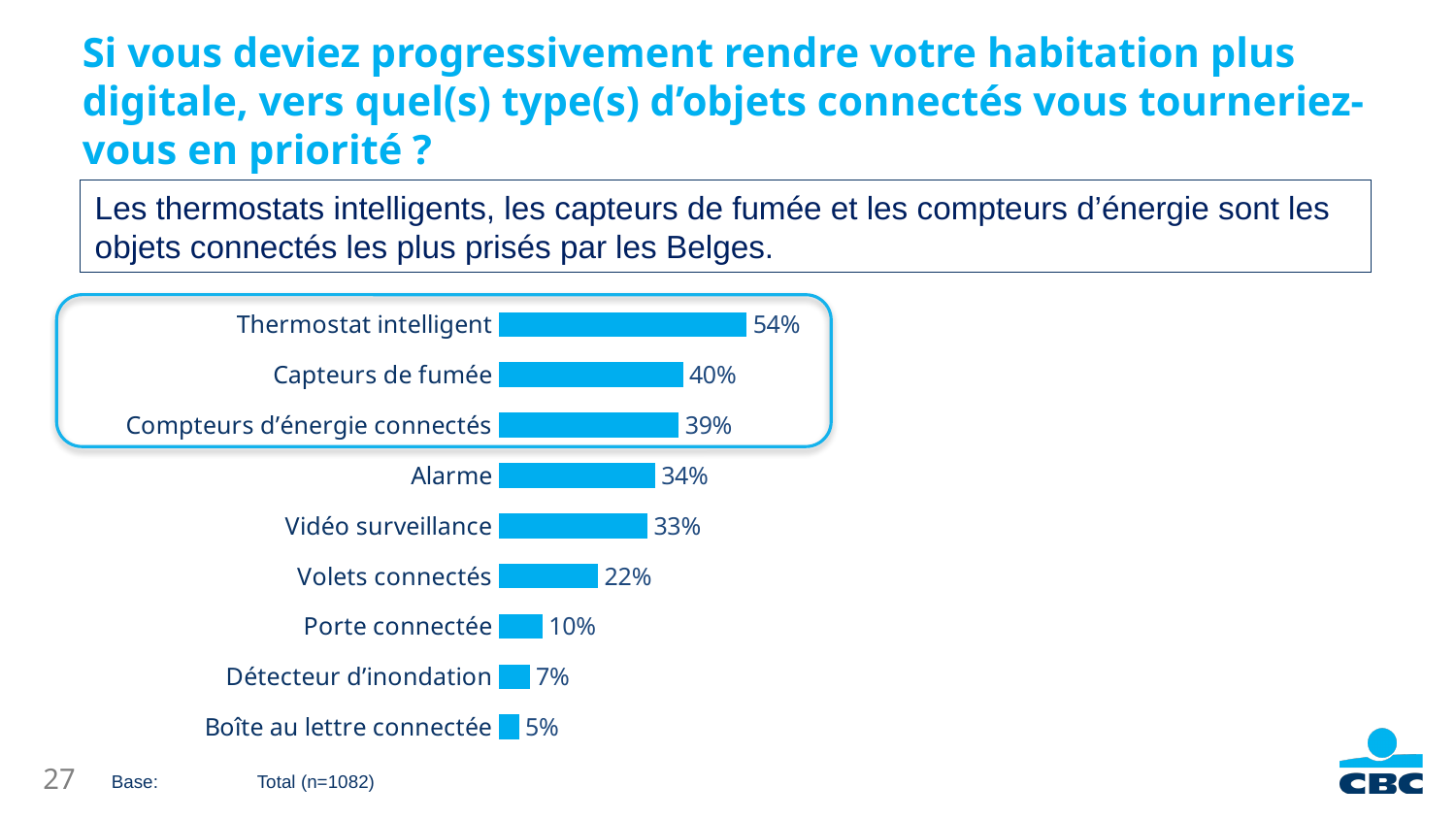
What is the value for Capteurs de fumée? 40% How many categories are shown in the chart? 9 Which category has the highest value? Thermostat intelligent What is the value for Détecteur d'inondation? 7% Which category has the lowest value? Boîte au lettre connectée What is the value for Volets connectés? 22% What is the difference between the values for Thermostat intelligent and Capteurs de fumée? 14% Which is larger, the value for Vidéo surveillance or the value for Volets connectés? Vidéo surveillance What is the difference between the values for Alarme and Porte connectée? 24% What is the value for Thermostat intelligent? 54% What kind of chart is shown on the slide? Bar chart What is the sample size (n) given in the base note below the chart? 1082